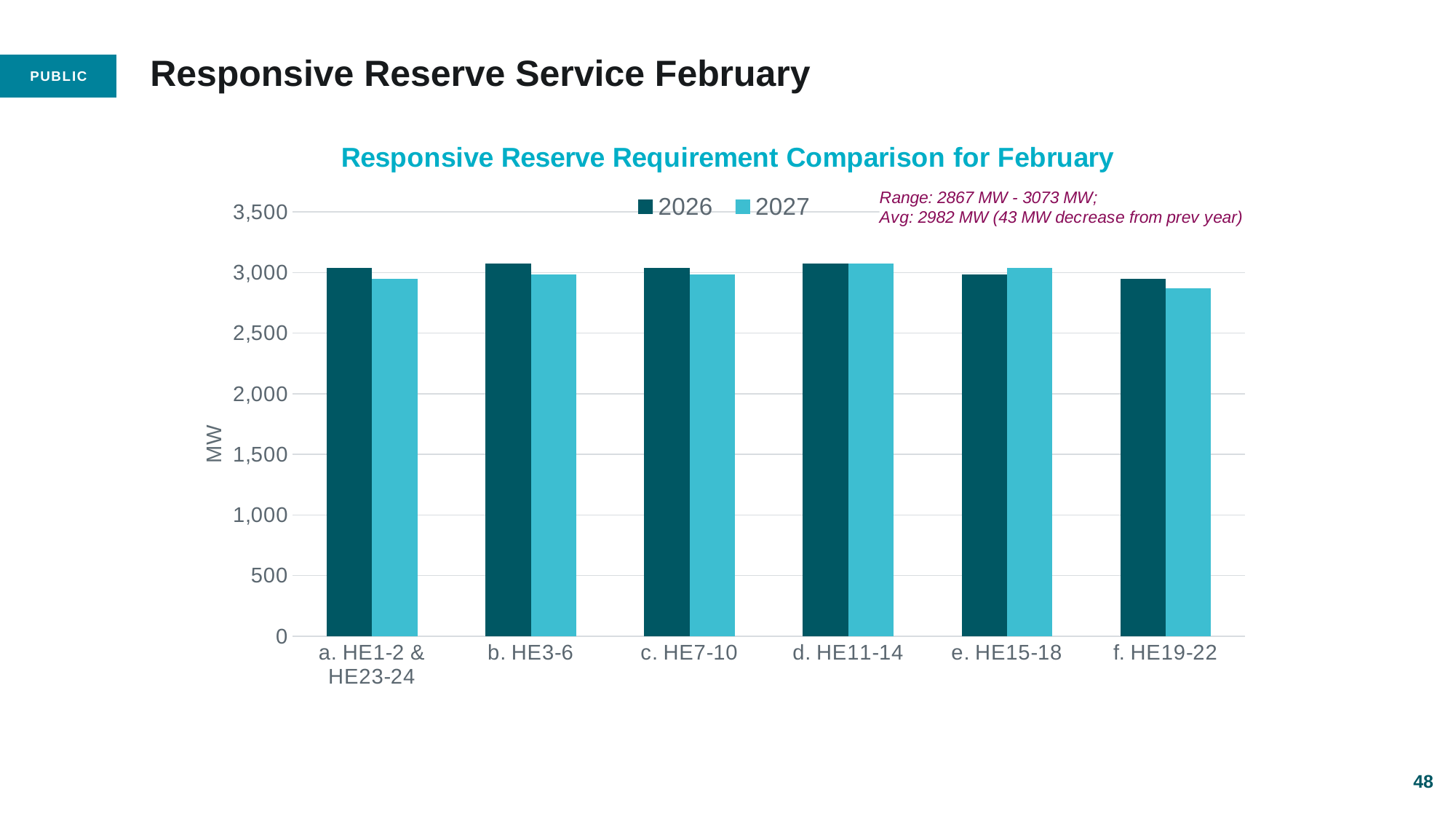
Is the 2027 value for f. HE19-22 greater or less than 3,000? less Which category has the lowest 2027 value? f. HE19-22 For e. HE15-18, which is larger, the 2026 value or the 2027 value? 2027 Is the 2026 value for b. HE3-6 greater or less than 2,500? greater Is the 2027 value for c. HE7-10 greater or less than 3,500? less How many series does the legend list? 2 What is the title of the chart? Responsive Reserve Requirement Comparison for February For f. HE19-22, which is larger, the 2026 value or the 2027 value? 2026 What label is shown on the vertical axis? MW For a. HE1-2 & HE23-24, which is larger, the 2026 value or the 2027 value? 2026 What kind of chart is shown on the slide? bar chart How many hour-block categories are shown on the x axis? 6